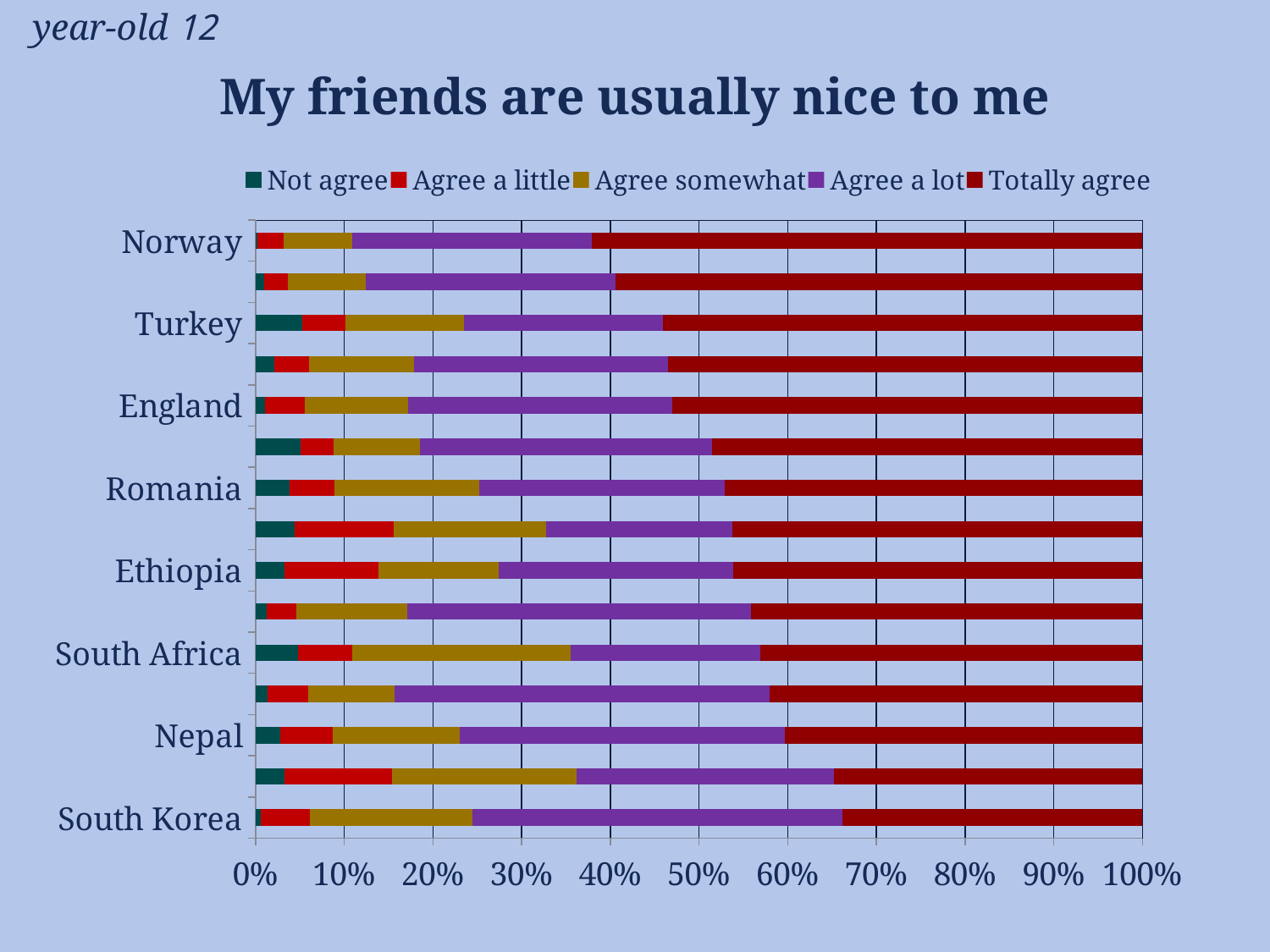
How many series does the legend list? 5 What kind of chart is shown on the slide? Stacked bar chart Among the labelled countries, which has the largest share of Totally agree? Norway Is the share of Totally agree for South Korea greater or less than 40%? less Is the share of Not agree for Turkey greater or less than 10%? less Which has a larger share of Totally agree, Norway or South Korea? Norway What is the title of the chart? My friends are usually nice to me Is the share of Totally agree for Nepal greater or less than 50%? less Which legend entry is shown in dark red? Totally agree Does the share of Totally agree rise or fall going down the chart from Norway to South Korea? fall